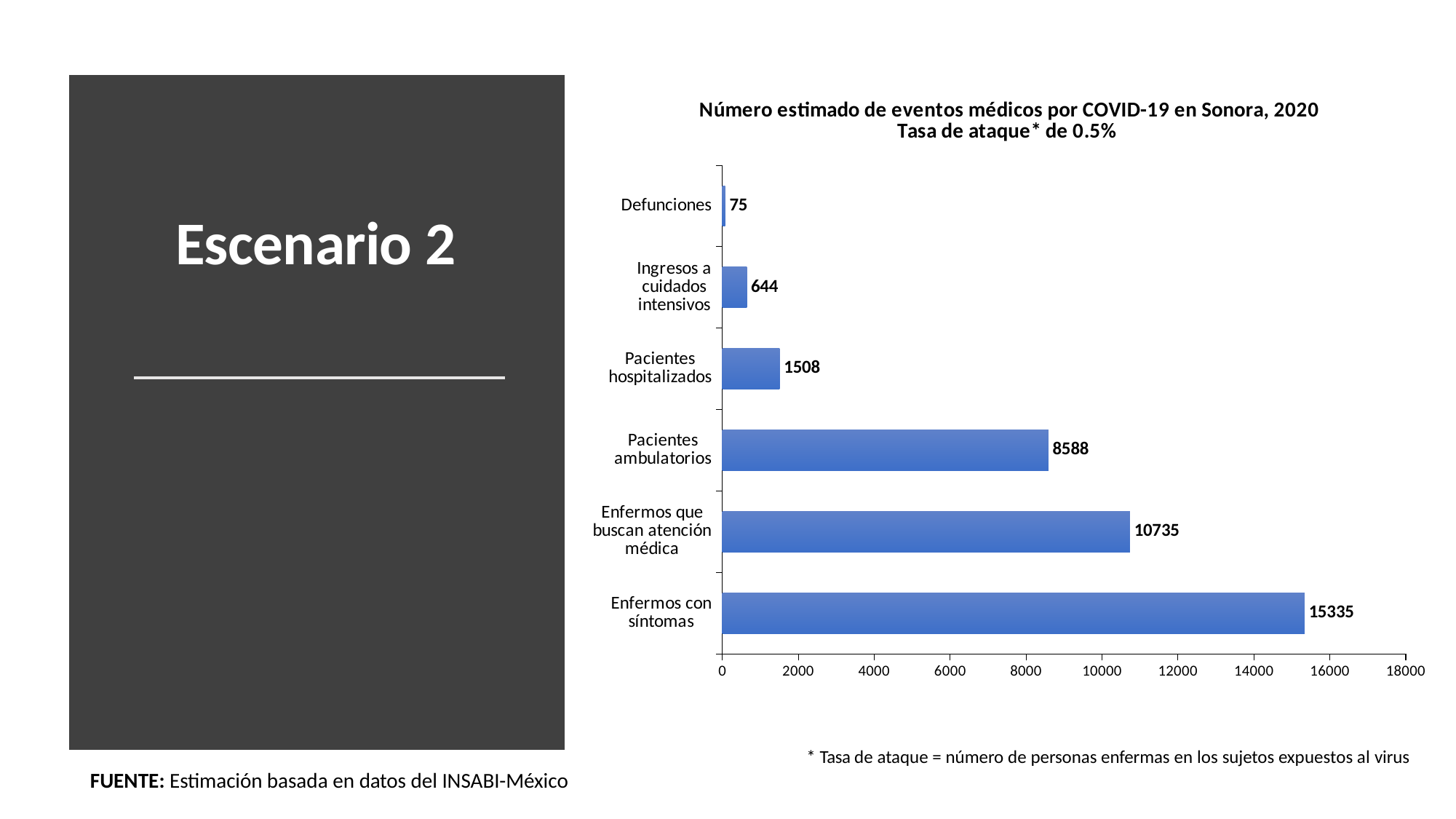
Which is larger, Pacientes ambulatorios or Pacientes hospitalizados? Pacientes ambulatorios How many categories are shown in the chart? 6 What is the value for Enfermos que buscan atención médica? 10735 Which category has the lowest value? Defunciones What is the value for Ingresos a cuidados intensivos? 644 What is the difference between Pacientes hospitalizados and Ingresos a cuidados intensivos? 864 What attack rate (tasa de ataque) is stated in the chart title? 0.5% What is the value for Pacientes hospitalizados? 1508 What is the estimated number of Defunciones? 75 Which category has the highest value? Enfermos con síntomas What type of chart is shown on the slide? Bar chart What is the difference between Enfermos con síntomas and Enfermos que buscan atención médica? 4600